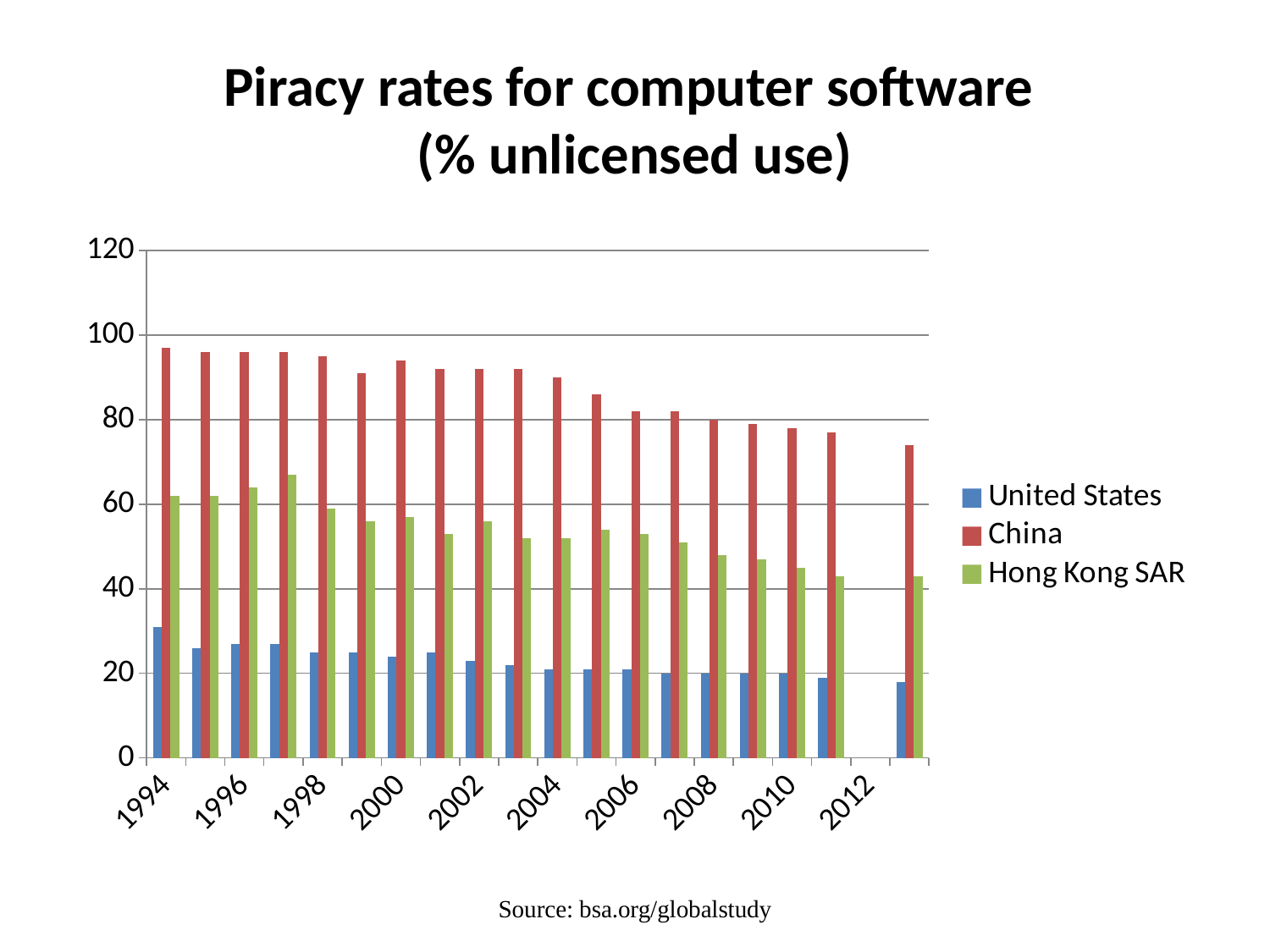
Which series has the highest value in 2010? China Is the value for the United States in 1994 greater or less than 40? less Which series are listed in the legend? United States, China, Hong Kong SAR Is the value for China in 1994 greater or less than 80? greater Do the values for Hong Kong SAR rise or fall from 1994 to the end of the x axis? fall Do the values for China rise or fall from 1994 to the end of the x axis? fall Is the value for China in 2000 greater or less than 100? less What kind of chart is shown on the slide? bar chart Which is larger in 1994, the value for China or the value for Hong Kong SAR? China What is the title of the chart? Piracy rates for computer software (% unlicensed use) How many series does the legend list? 3